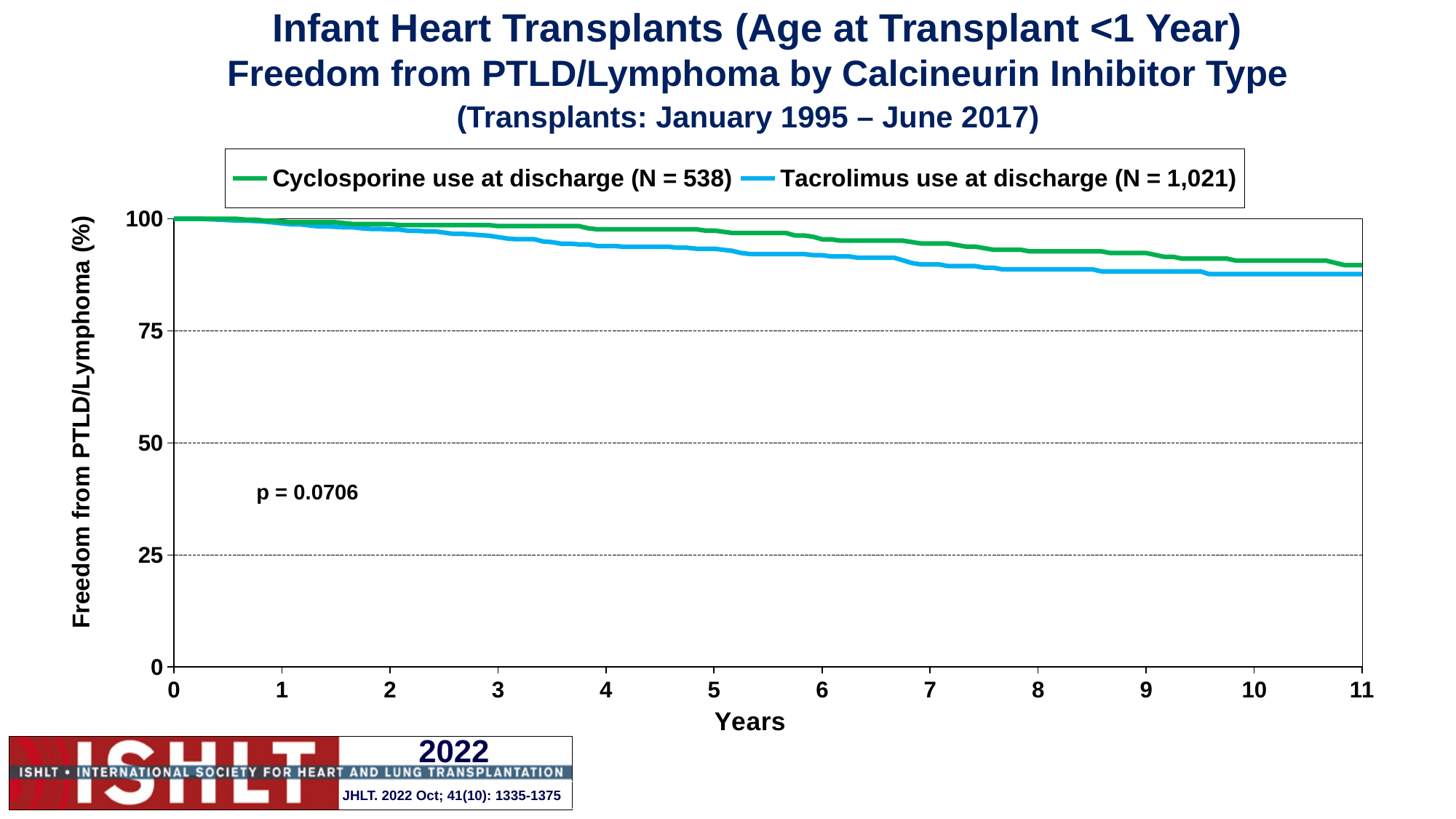
Is the value for Tacrolimus use at discharge at year 11 greater or less than 75? greater What is the label of the x axis? Years How many series does the legend list? 2 Is the value for Cyclosporine use at discharge at year 11 greater or less than 75? greater At year 7, which series has the higher freedom from PTLD/Lymphoma, Cyclosporine use at discharge or Tacrolimus use at discharge? Cyclosporine use at discharge What is the value of both series at year 0? 100 What kind of chart is shown on the slide? line chart What is the p-value printed on the chart? p = 0.0706 What is the label of the y axis? Freedom from PTLD/Lymphoma (%) What is the N for the Cyclosporine use at discharge series? 538 What is the N for the Tacrolimus use at discharge series? 1,021 Do the values for Tacrolimus use at discharge rise or fall as years increase? fall